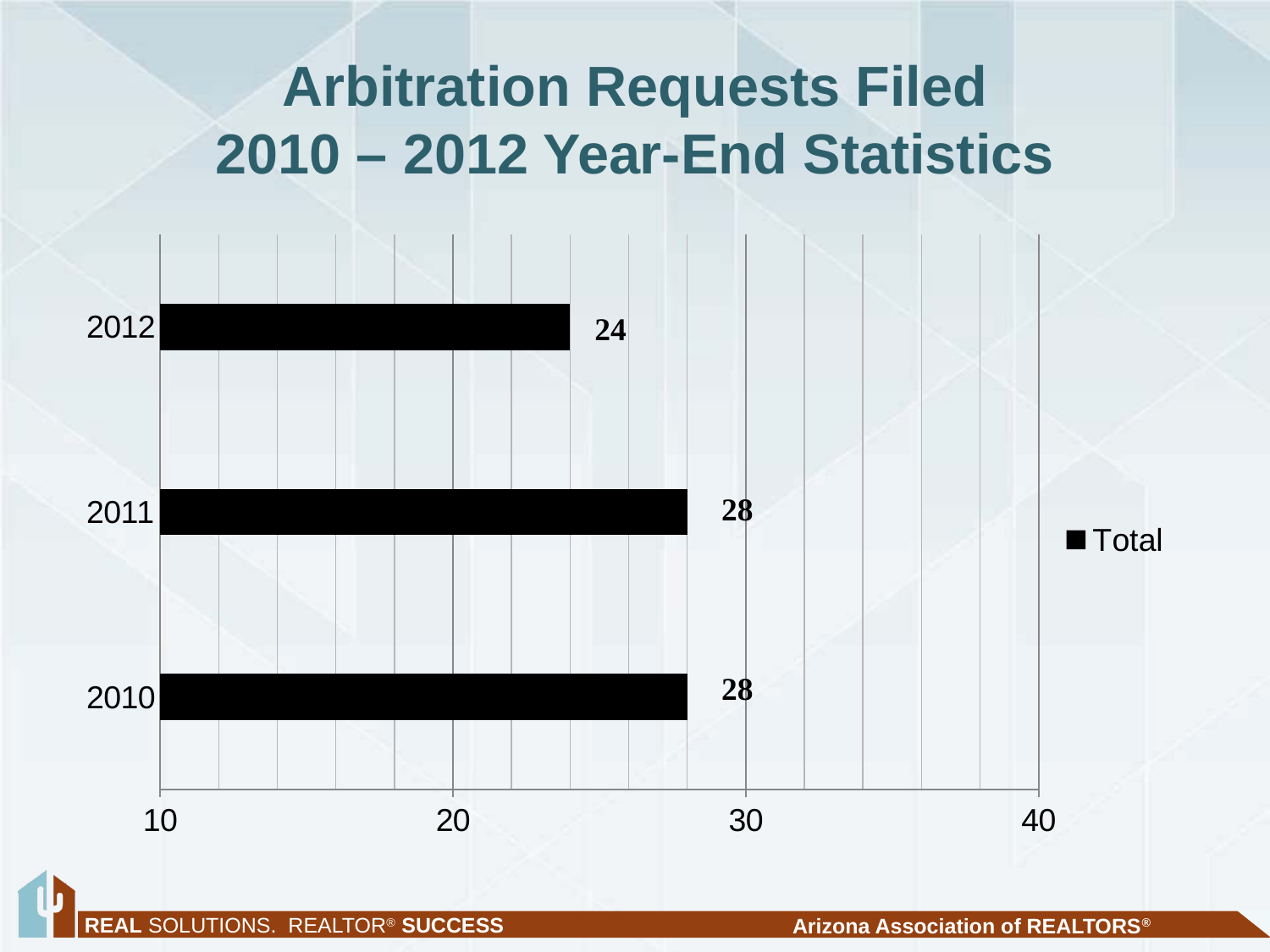
Is the value for 2012 greater or less than 30? less How many series does the legend list? 1 Is the value for 2011 greater or less than 20? greater What is the value for 2011? 28 What is the value for 2012? 24 Which is larger, the value for 2010 or the value for 2012? 2010 What kind of chart is shown on the slide? bar chart What is the name of the series shown in the legend? Total What is the difference between the values for 2011 and 2012? 4 How many years are shown on the chart? 3 What is the value for 2010? 28 Which year has the lowest value? 2012